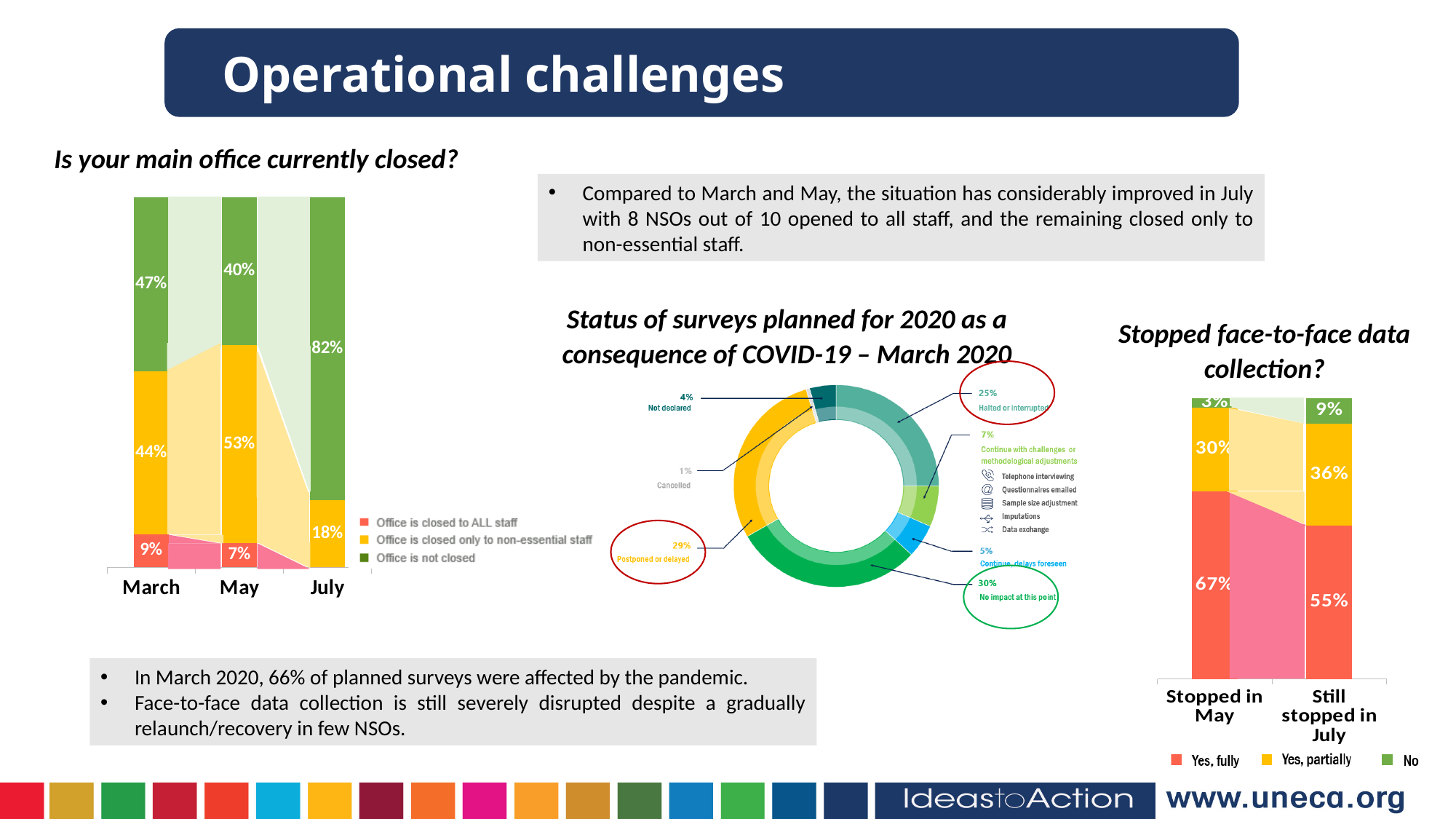
In the 'Is your main office currently closed?' chart, what is the difference in percentage points between 'Office is not closed' in July and in March? 35 percentage points In the 'Is your main office currently closed?' chart, what percentage is shown for 'Office is closed only to non-essential staff' in May? 53% In the 'Stopped face-to-face data collection?' chart, is the 'Yes, partially' value larger for 'Stopped in May' or 'Still stopped in July'? Still stopped in July In the 'Is your main office currently closed?' chart, which month has the highest value for 'Office is closed to ALL staff'? March How many series does the legend of the 'Is your main office currently closed?' chart list? 3 In the 'Stopped face-to-face data collection?' chart, what percentage answered 'Yes, fully' for 'Stopped in May'? 67% What kind of chart is the 'Is your main office currently closed?' chart? Stacked bar chart In the 'Status of surveys planned for 2020' chart, what share is labelled 'Postponed or delayed'? 29% In the 'Status of surveys planned for 2020' chart, what share is labelled 'No impact at this point'? 30% In the 'Stopped face-to-face data collection?' chart, what percentage answered 'No' for 'Still stopped in July'? 9% In the 'Is your main office currently closed?' chart, what percentage is shown for 'Office is not closed' in July? 82% What kind of chart is the 'Status of surveys planned for 2020' chart? Doughnut chart